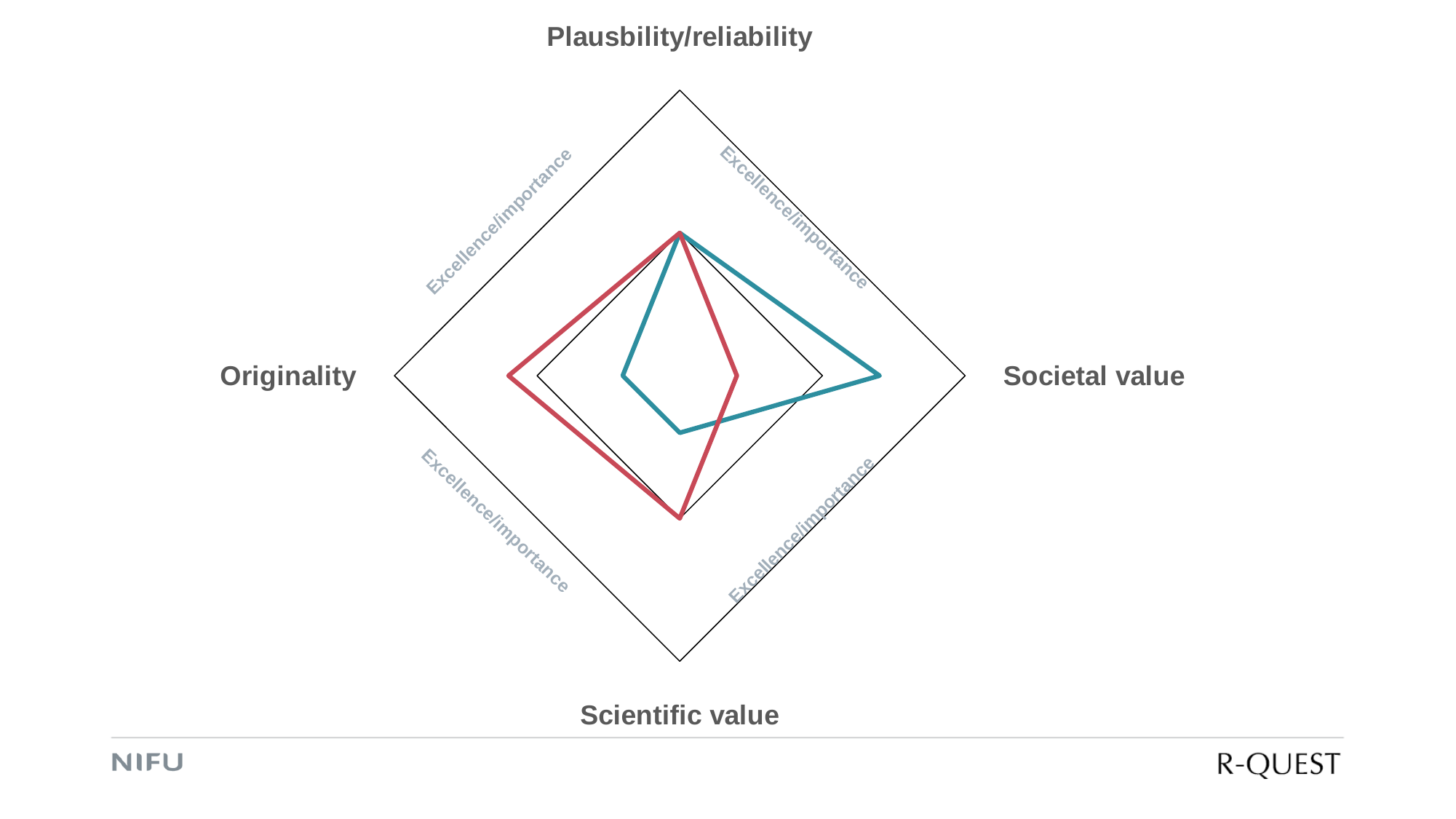
On which axis does the teal series reach its highest value? Societal value Which category is labelled at the top of the radar chart? Plausbility/reliability How many axes (categories) does the radar chart have? 4 Which category is labelled at the bottom of the radar chart? Scientific value What kind of chart is shown on the slide? Radar chart On which axis does the red series have its lowest value? Societal value On the Scientific value axis, which series has the larger value, red or teal? Red How many data series (lines) are plotted on the radar chart? 2 On which axis does the red series reach its highest value? Originality On the Originality axis, which series has the larger value, red or teal? Red On the Societal value axis, which series has the larger value, red or teal? Teal